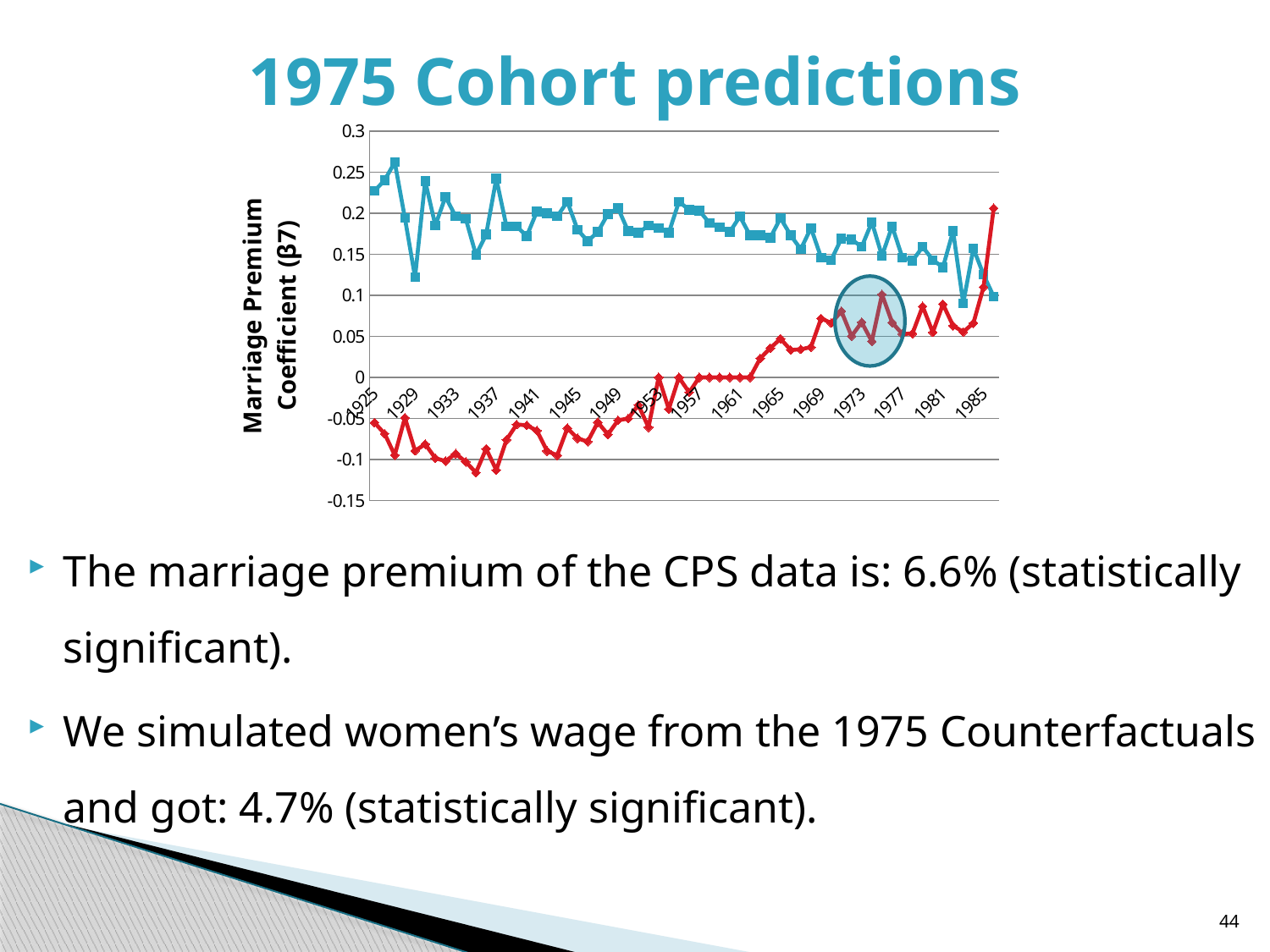
What kind of chart is shown on the slide? line chart Which series reaches the lowest value on the chart, the blue or the red? red Is the value of the blue series at 1985 greater or less than 0.15? less At the final point on the right of the chart, which series has the higher value, the blue or the red? red How many data series are plotted on the chart? 2 What is the title of the vertical axis? Marriage Premium Coefficient (β7) Does the red (diamond-marker) series generally rise or fall from 1925 to 1985? rise At 1925, which series has the higher value, the blue or the red? blue Is the value of the red series at 1945 greater or less than -0.05? less Is the value of the blue series at 1925 greater or less than 0.2? greater Does the blue (square-marker) series generally rise or fall from 1925 to 1985? fall How many year labels are shown on the horizontal axis? 16